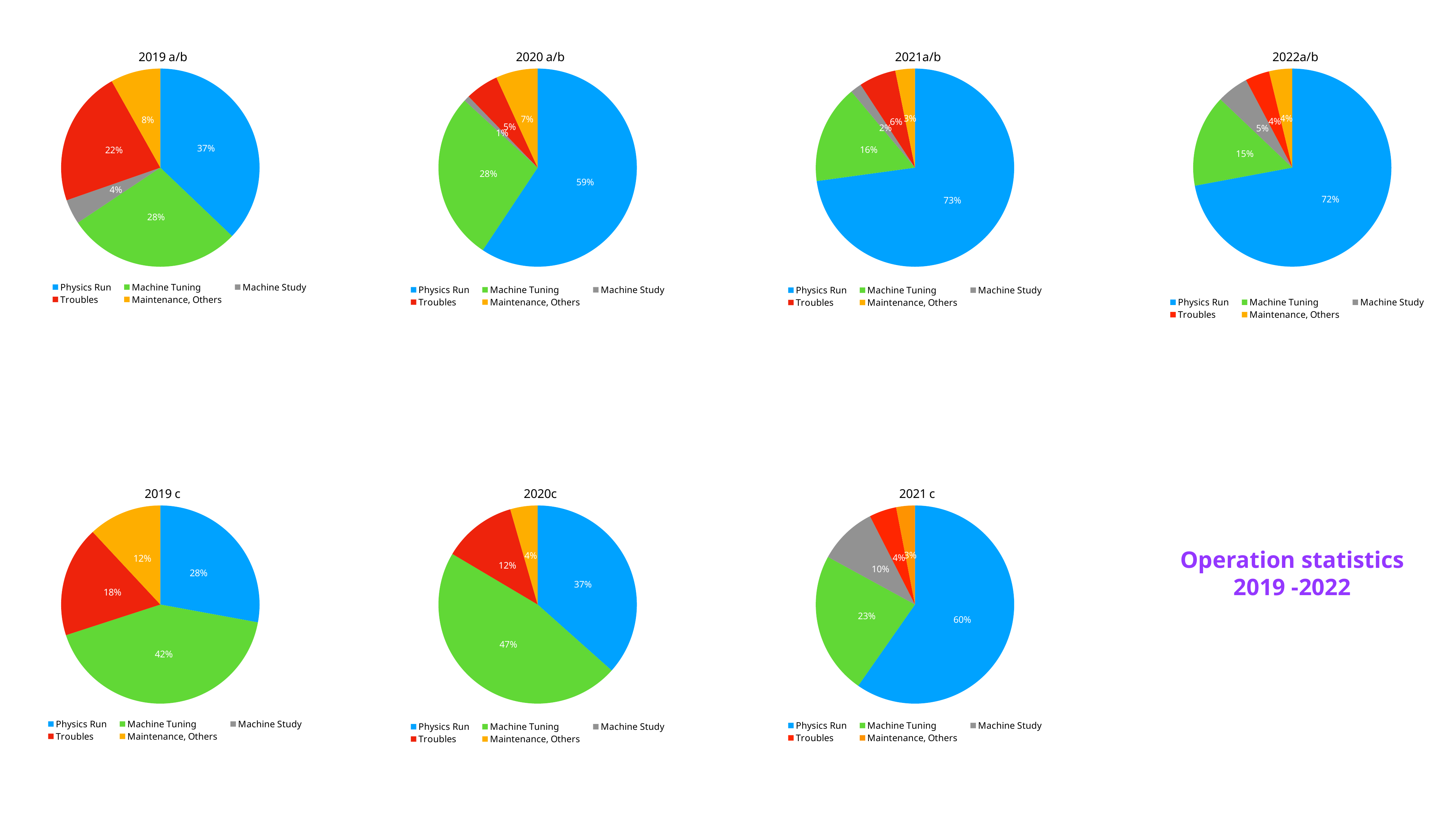
In the 2021 c chart, which is larger, Machine Tuning or Machine Study? Machine Tuning In the 2020c chart, what is the difference between the Machine Tuning share and the Physics Run share? 10% How many entries does the legend of the 2019 a/b chart list? 5 In the 2019 c chart, what share is Maintenance, Others? 12% In the 2019 a/b chart, what share is Physics Run? 37% In the 2020 a/b chart, what share is Machine Study? 1% In the 2019 a/b chart, what share is Troubles? 22% In the 2019 c chart, which category has the largest share? Machine Tuning What kind of chart is the 2020 a/b chart? Pie chart In the 2022a/b chart, what share is Machine Tuning? 15% In the 2021 c chart, what share is Machine Study? 10% In the 2021a/b chart, which category has the largest share? Physics Run